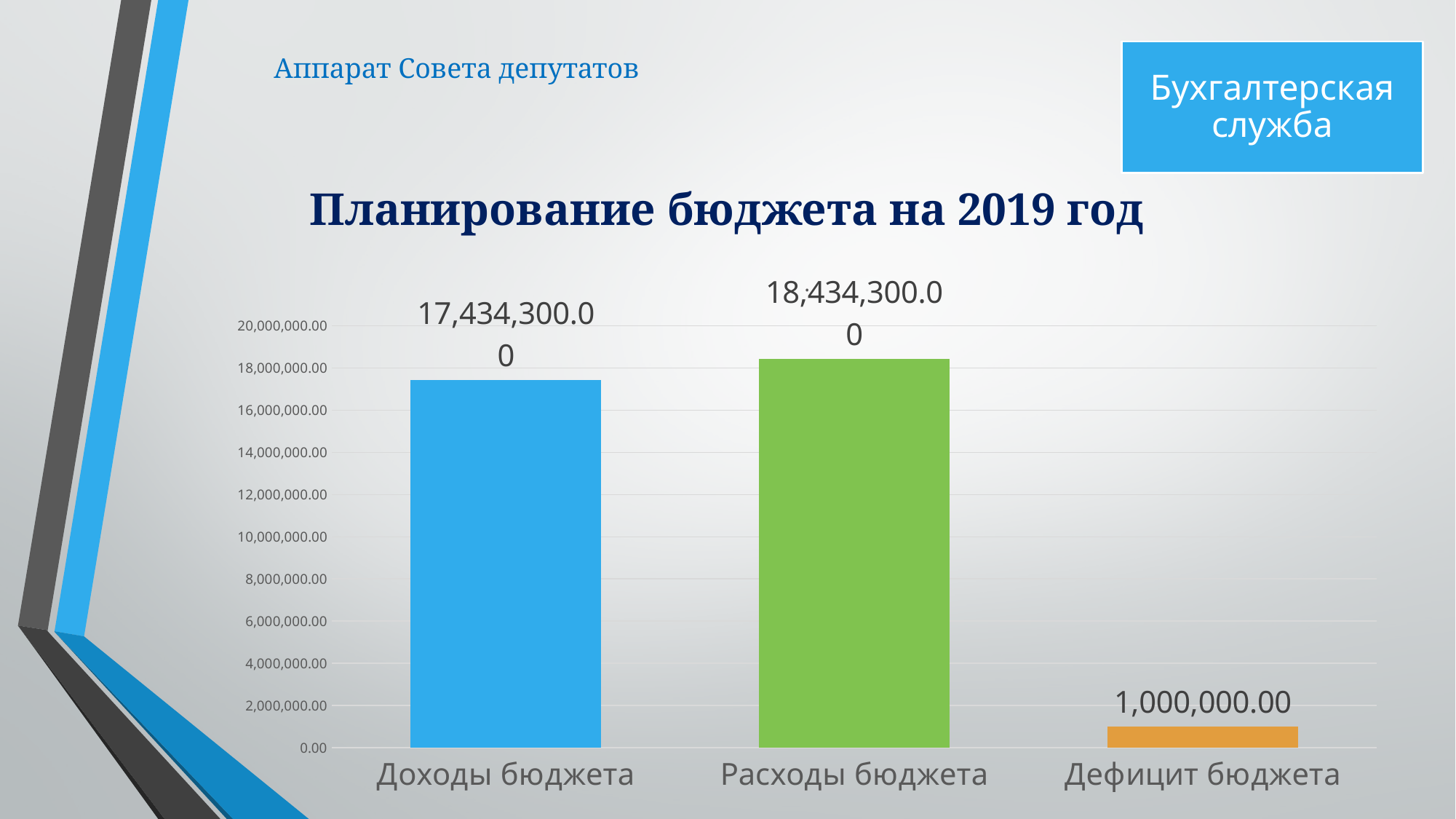
What is the value for Расходы бюджета? 18,434,300.00 Which category has the highest value? Расходы бюджета Is the value for Доходы бюджета greater or less than 16,000,000.00? greater What is the title of the chart? Планирование бюджета на 2019 год What is the value for Доходы бюджета? 17,434,300.00 What is the value for Дефицит бюджета? 1,000,000.00 What is the difference between Расходы бюджета and Доходы бюджета? 1,000,000.00 What kind of chart is shown on the slide? bar chart How many categories are shown in the chart? 3 Which is larger, Доходы бюджета or Расходы бюджета? Расходы бюджета Which category has the lowest value? Дефицит бюджета Is the value for Дефицит бюджета greater or less than 2,000,000.00? less